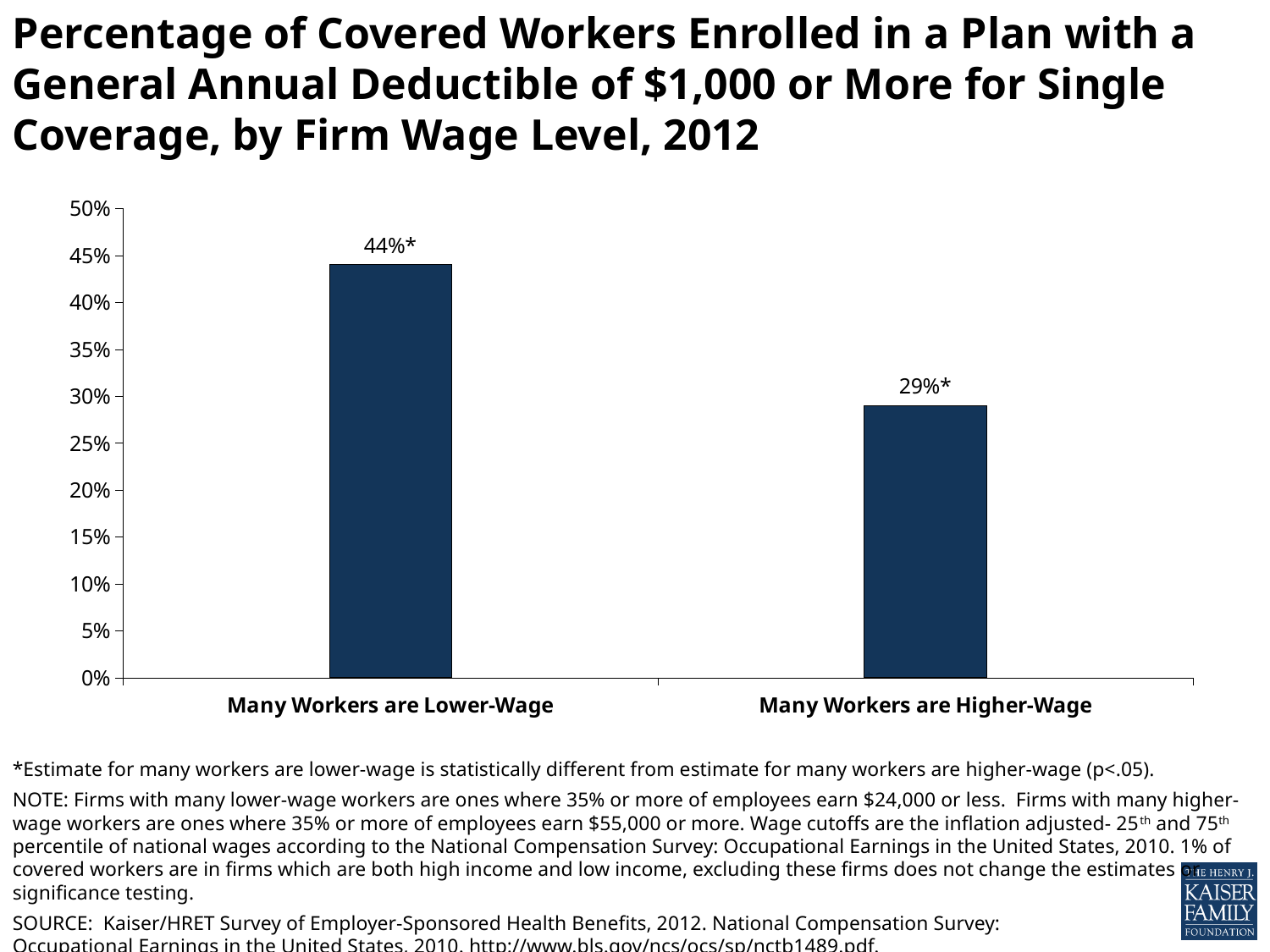
What is the highest value shown on the vertical axis? 50% What kind of chart is shown on the slide? bar chart Is the value for Many Workers are Lower-Wage greater or less than 40%? greater Which category has the highest value? Many Workers are Lower-Wage How many categories are shown on the chart? 2 What is the value for Many Workers are Higher-Wage? 29% What is the difference between the values for Many Workers are Lower-Wage and Many Workers are Higher-Wage? 15% Is the value for Many Workers are Higher-Wage greater or less than 30%? less Which is larger, the value for Many Workers are Lower-Wage or Many Workers are Higher-Wage? Many Workers are Lower-Wage What is the value for Many Workers are Lower-Wage? 44% Which category has the lowest value? Many Workers are Higher-Wage What year does the chart title refer to? 2012